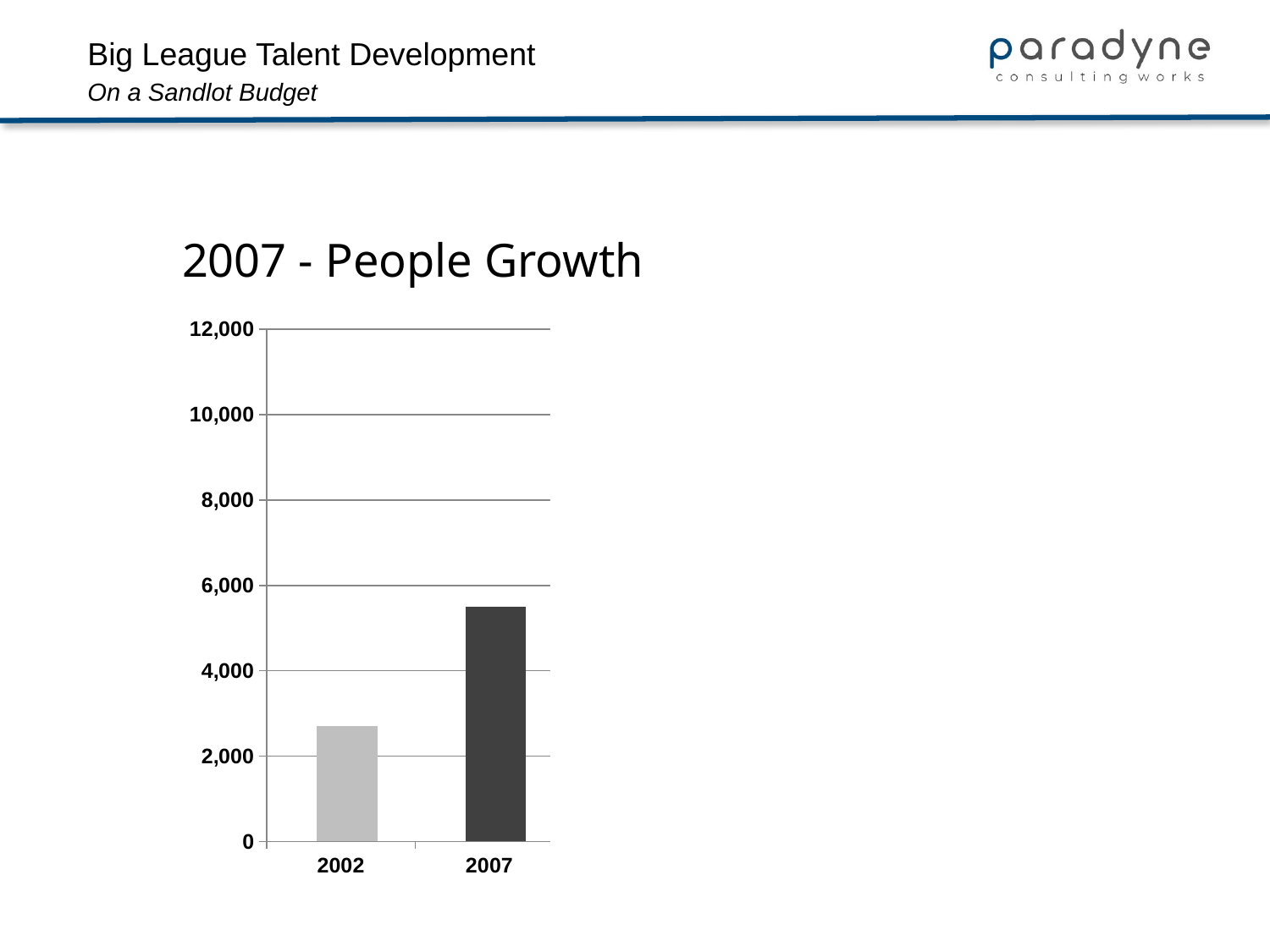
Is the value for 2007 greater or less than 4,000? greater What is the highest value shown on the y axis? 12,000 Do the values rise or fall from 2002 to 2007? rise Is the value for 2002 greater or less than 4,000? less Which is larger, the value for 2002 or the value for 2007? 2007 What is the title of the chart? 2007 - People Growth Which year has the lowest value? 2002 How many categories are plotted on the x axis? 2 What kind of chart is shown on the slide? bar chart Is the value for 2007 greater or less than 6,000? less Which year has the highest value? 2007